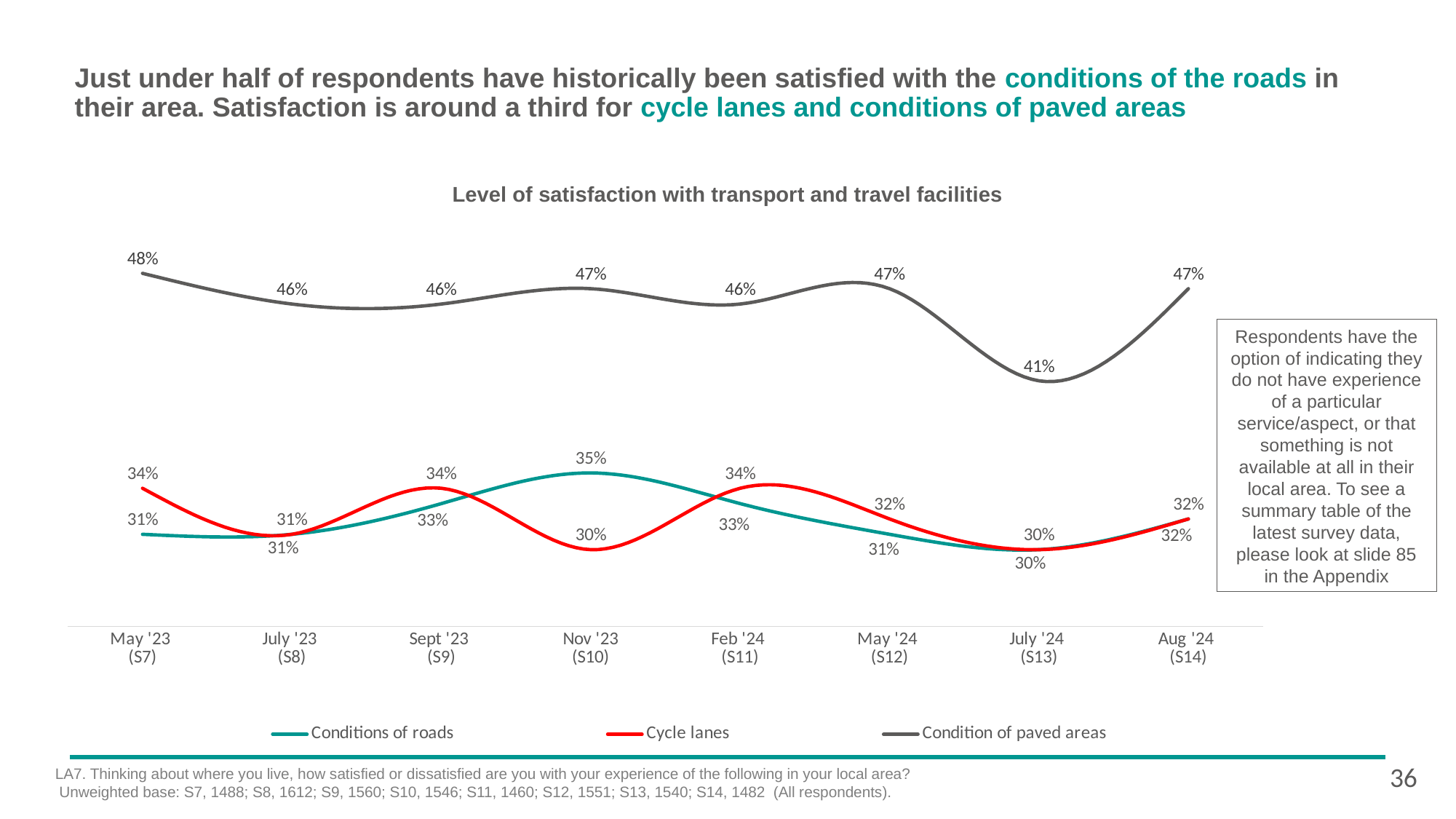
What is the value of the grey line (Condition of paved areas) at July '24 (S13)? 41% At which survey wave does the grey line (Condition of paved areas) reach its lowest value? July '24 (S13) At which survey wave does the grey line (Condition of paved areas) reach its highest value? May '23 (S7) What is the title of the chart? Level of satisfaction with transport and travel facilities What is the value of the red line (Cycle lanes) at Feb '24 (S11)? 34% What type of chart is shown on the slide? Line chart What is the value of the teal line (Conditions of roads) at Nov '23 (S10)? 35% What is the difference between the grey line's value at May '23 (48%) and at July '24 (41%)? 7 percentage points Does the grey line (Condition of paved areas) rise or fall between May '24 and July '24? Fall How many series does the legend list? 3 How many survey waves (time points) are plotted along the x axis? 8 At Nov '23 (S10), which is higher: the teal line (Conditions of roads) or the red line (Cycle lanes)? Conditions of roads (teal)